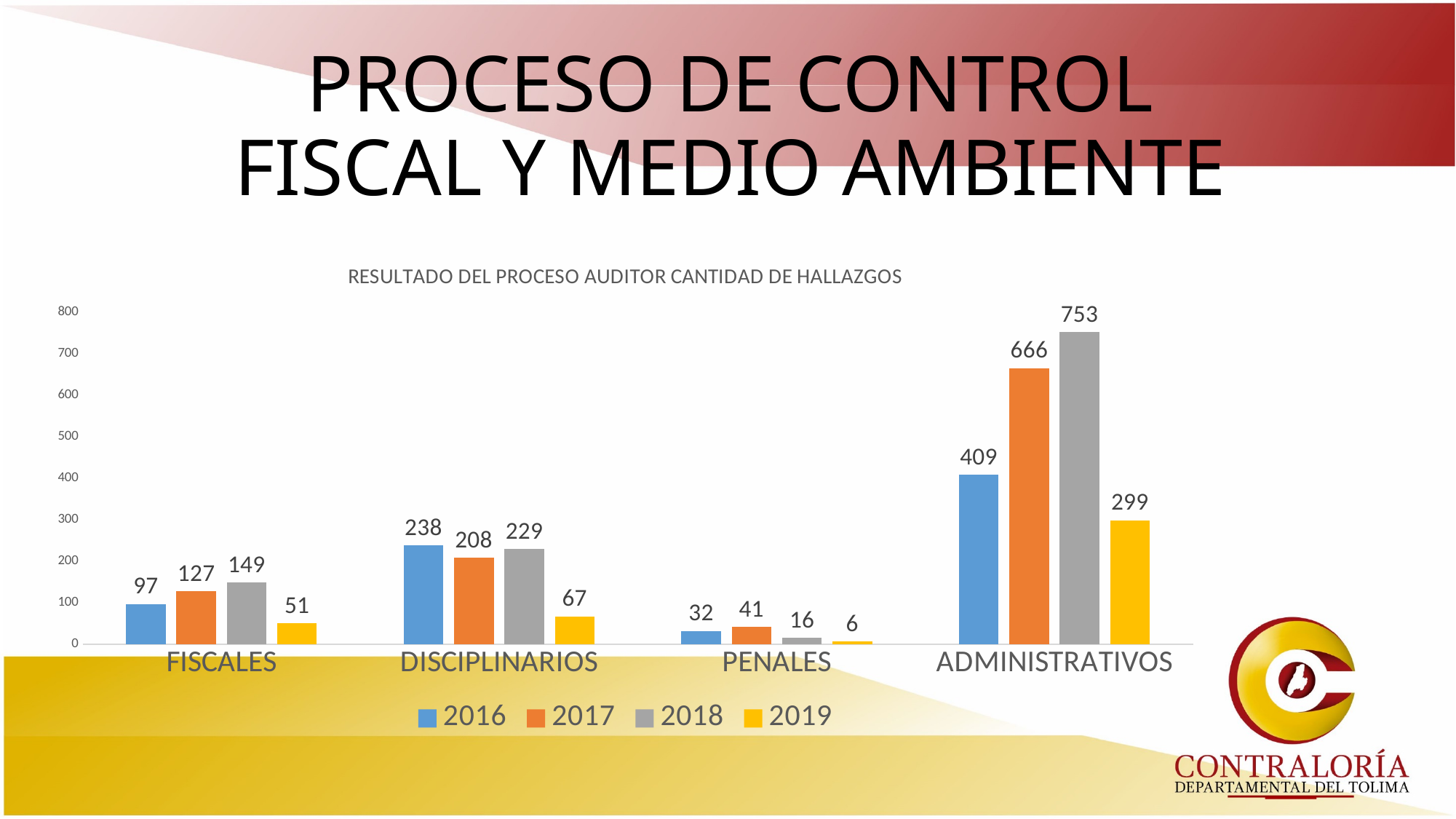
What kind of chart is shown on the slide? Bar chart What is the title of the chart? RESULTADO DEL PROCESO AUDITOR CANTIDAD DE HALLAZGOS What is the value for PENALES in 2019? 6 Which category has the lowest value in 2018? PENALES How many categories are shown on the x axis? 4 What is the value for DISCIPLINARIOS in 2017? 208 How many series does the legend list? 4 What is the value for ADMINISTRATIVOS in 2018? 753 Which is larger for DISCIPLINARIOS, the 2016 value or the 2018 value? 2016 Which category has the highest value in 2017? ADMINISTRATIVOS What is the difference between the 2018 and 2017 values for ADMINISTRATIVOS? 87 What is the value for FISCALES in 2016? 97